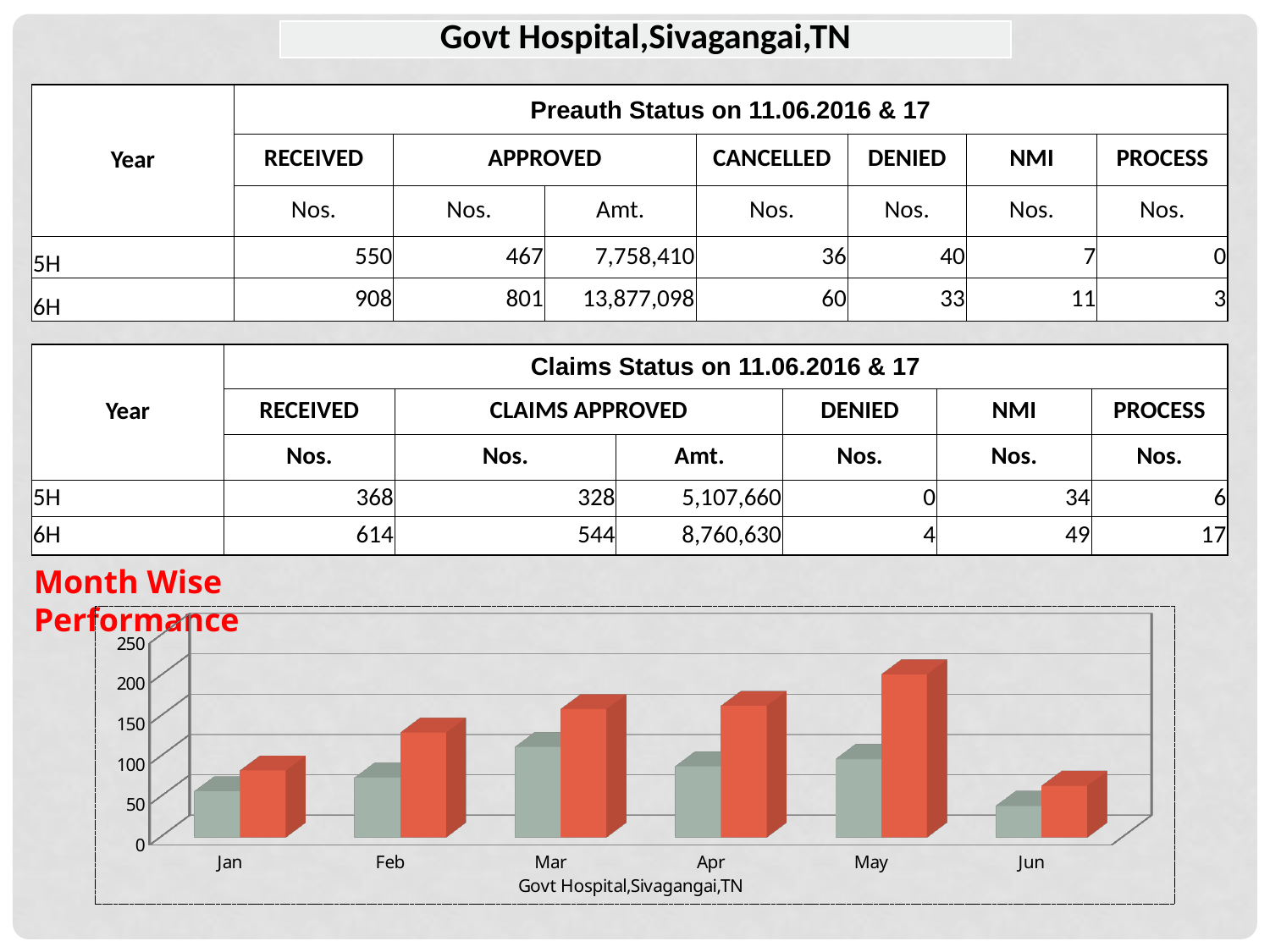
In the Month Wise Performance chart, do the red bars rise or fall from Jan to May? rise How many months are shown on the x axis of the Month Wise Performance chart? 6 In the Month Wise Performance chart, is the red bar for May greater or less than 150? greater In the Month Wise Performance chart, is the red bar for Jan greater or less than 100? less In the Month Wise Performance chart, which month has the shortest red bar? Jun What is the label printed beneath the x axis of the Month Wise Performance chart? Govt Hospital,Sivagangai,TN What kind of chart is shown under the heading "Month Wise Performance"? bar chart In the Month Wise Performance chart, which month has the shortest grey bar? Jun How many bars are plotted for each month in the Month Wise Performance chart? 2 In the Month Wise Performance chart, which is larger for Mar, the grey bar or the red bar? the red bar In the Month Wise Performance chart, is the grey bar for Feb greater or less than 100? less In the Month Wise Performance chart, which month has the tallest red bar? May